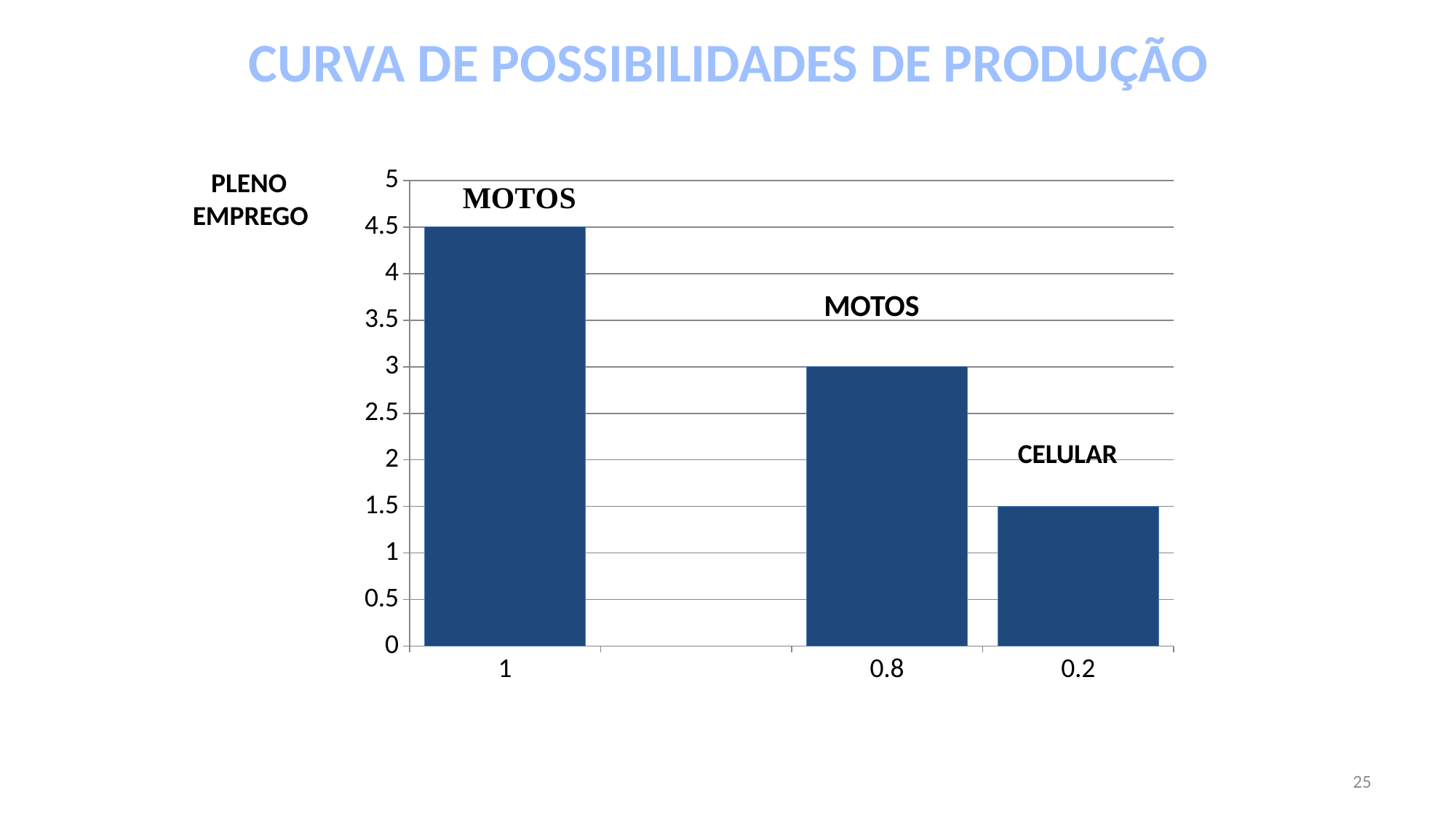
What is the title of the chart on the slide? CURVA DE POSSIBILIDADES DE PRODUÇÃO What is the difference between the bar at category 0.8 and the bar at category 0.2? 1.5 What is the value of the bar at x-axis category 0.8? 3 Do the bar values rise or fall from left to right along the x axis? fall What is the value of the bar at x-axis category 0.2? 1.5 Which x-axis category has the highest bar? 1 What type of chart is shown on the slide? bar chart What is the difference between the bar at category 1 and the bar at category 0.8? 1.5 How many bars are plotted in the chart? 3 What is the value of the bar at x-axis category 1? 4.5 Which is larger, the bar at category 0.8 or the bar at category 0.2? 0.8 Which x-axis category has the lowest bar? 0.2